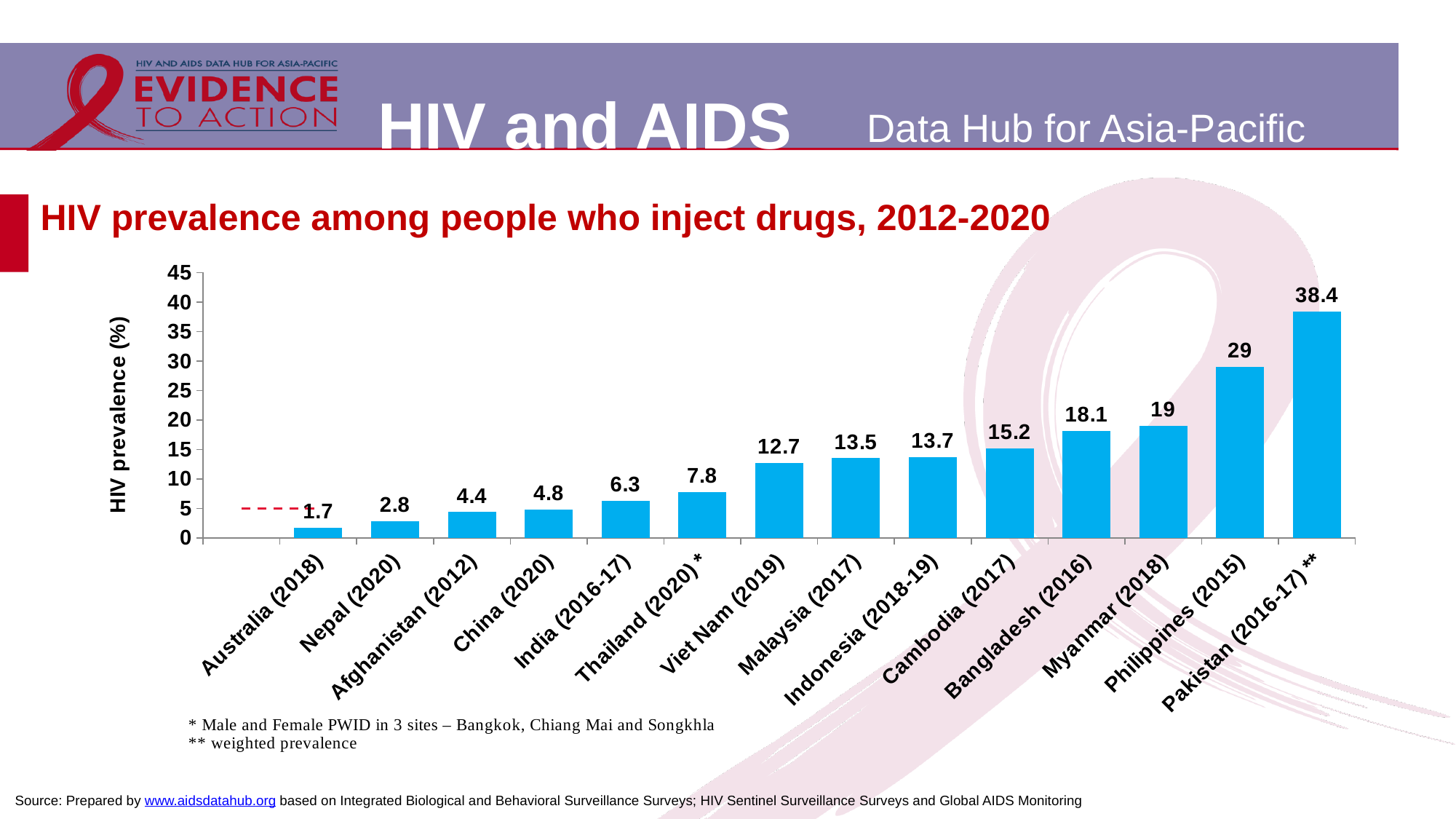
Which has a higher HIV prevalence among people who inject drugs: Myanmar (2018) or Cambodia (2017)? Myanmar (2018) Do the values rise or fall from left to right across the chart? Rise Which country has the highest HIV prevalence among people who inject drugs on the chart? Pakistan (2016-17) What is the difference in HIV prevalence between Pakistan (2016-17) and Philippines (2015)? 9.4 Which country has the lowest HIV prevalence among people who inject drugs on the chart? Australia (2018) Is the HIV prevalence for Philippines (2015) greater or less than 25? greater How many countries are shown on the chart? 14 What is the HIV prevalence among people who inject drugs in Bangladesh (2016)? 18.1 What is the HIV prevalence among people who inject drugs in Viet Nam (2019)? 12.7 What type of chart is used to show HIV prevalence among people who inject drugs? Bar chart What is the label of the y-axis on the chart? HIV prevalence (%) What is the HIV prevalence among people who inject drugs in Thailand (2020)? 7.8